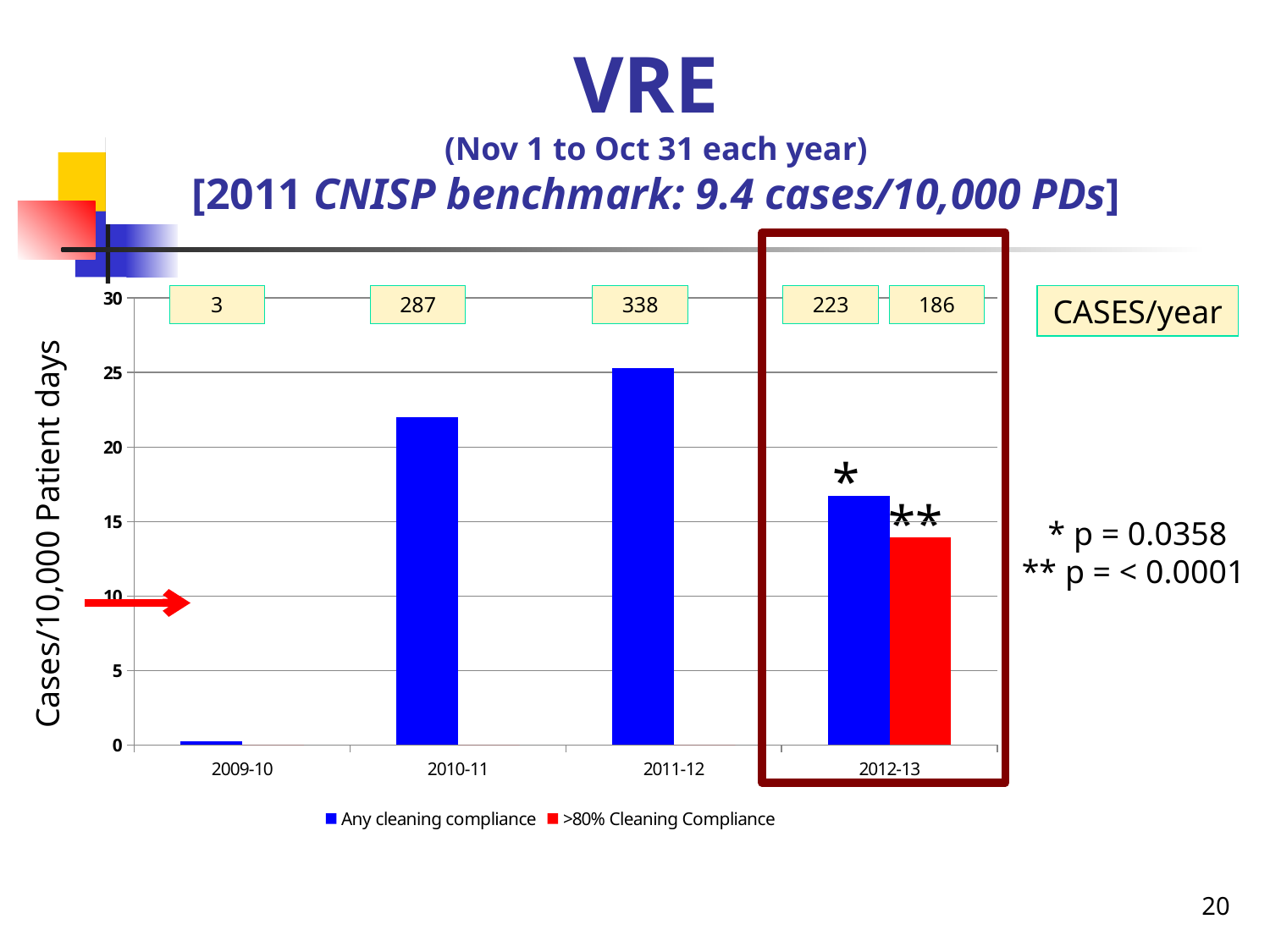
How many year categories are shown on the x axis? 4 Is the 'Any cleaning compliance' value for 2010-11 greater or less than 20? greater Is the 'Any cleaning compliance' value for 2009-10 greater or less than 5? less In 2012-13, which series has the larger value: 'Any cleaning compliance' or '>80% Cleaning Compliance'? Any cleaning compliance How many series does the legend list? 2 How does the 'Any cleaning compliance' rate change from 2009-10 to 2011-12? It rises Which year has the highest rate for the 'Any cleaning compliance' series? 2011-12 What kind of chart is shown on the slide? bar chart Which year has the lowest rate for the 'Any cleaning compliance' series? 2009-10 What is the label on the y axis of the chart? Cases/10,000 Patient days Is the '>80% Cleaning Compliance' value for 2012-13 greater or less than 15? less Which is larger for the 'Any cleaning compliance' series: 2010-11 or 2012-13? 2010-11